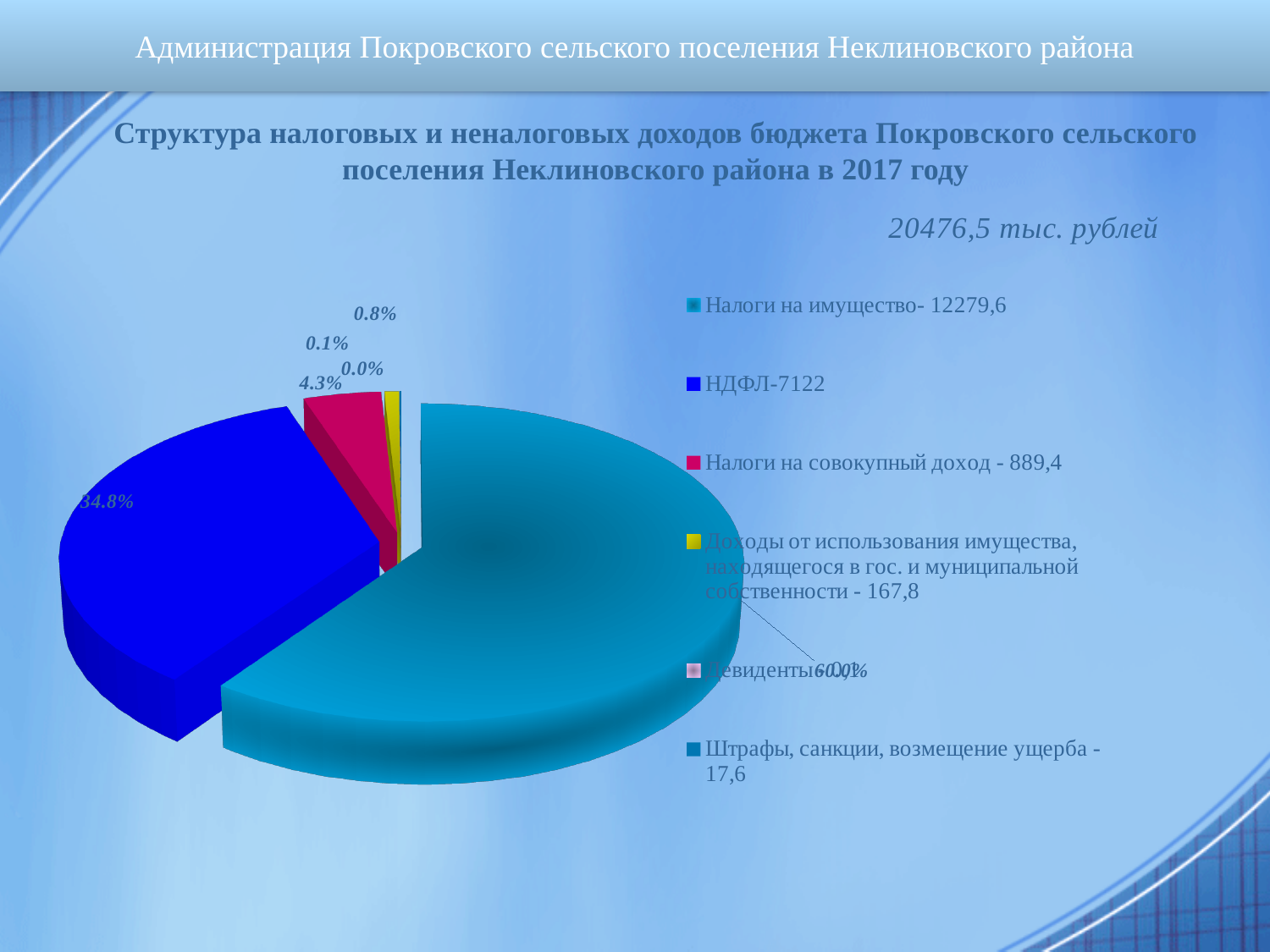
What kind of chart is shown on the slide? pie chart Which category has the largest share of the pie? Налоги на имущество What share of the pie does НДФЛ take? 34.8% What total amount in thousand rubles is stated above the chart? 20476,5 тыс. рублей How many categories does the legend of the pie chart list? 6 What value is given in the legend for Налоги на совокупный доход? 889,4 What value is given in the legend for Штрафы, санкции, возмещение ущерба? 17,6 What share of the pie does Налоги на имущество take? 60.0% What is the difference between the values for Налоги на имущество (12279,6) and НДФЛ (7122)? 5157,6 What value is given in the legend for Доходы от использования имущества, находящегося в гос. и муниципальной собственности? 167,8 What share of the pie does Налоги на совокупный доход take? 4.3% Which is larger, НДФЛ or Налоги на совокупный доход? НДФЛ